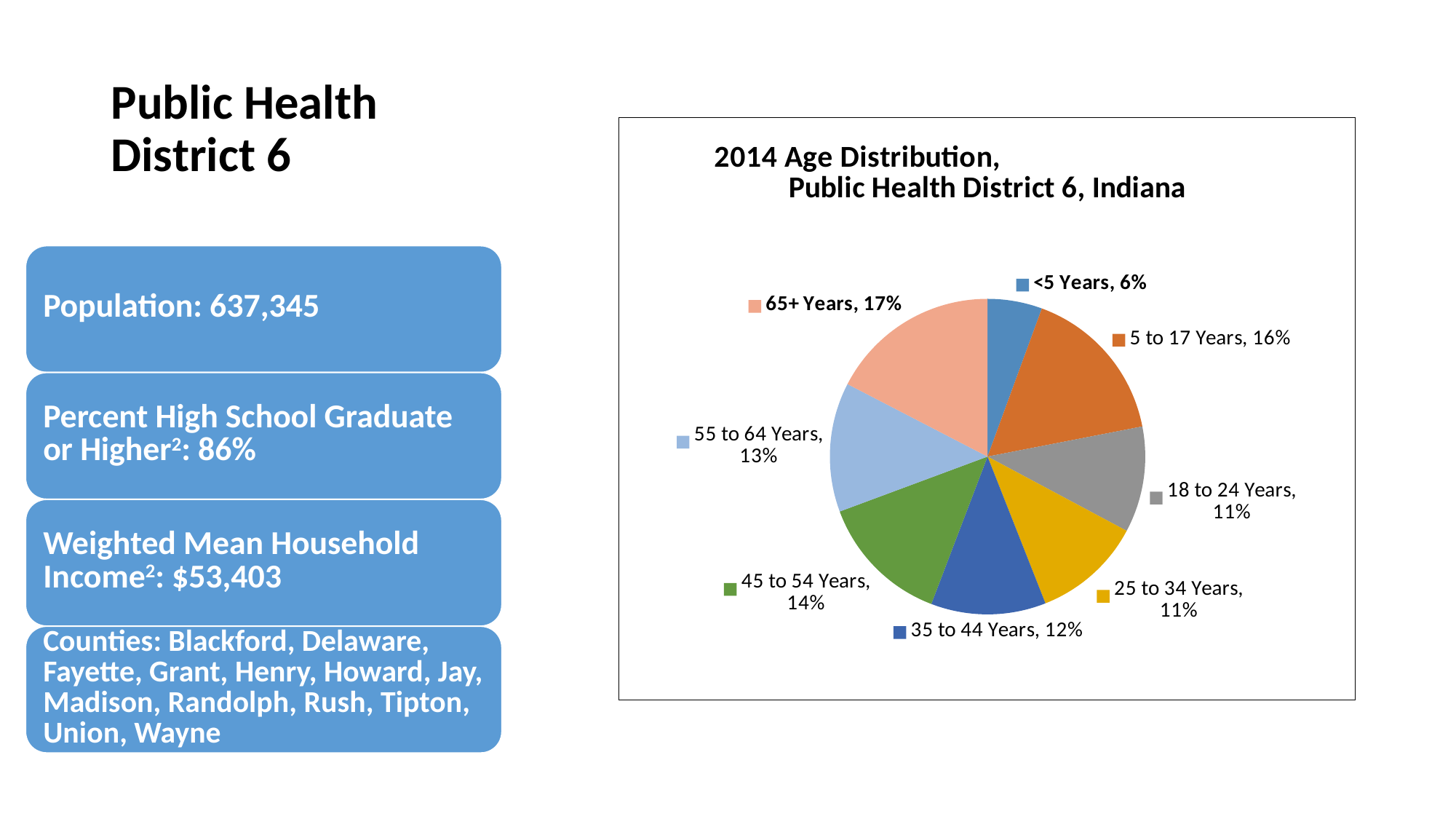
What share of the population is 45 to 54 Years? 14% What is the chart's title? 2014 Age Distribution, Public Health District 6, Indiana Which age group has the smallest share of the pie? <5 Years What share of the population is 5 to 17 Years? 16% What share of the population is 65+ Years? 17% Which age group has the largest share of the pie? 65+ Years What type of chart is shown on the slide? pie chart What is the combined share of the 18 to 24 Years and 25 to 34 Years slices? 22% What share of the population is <5 Years? 6% What is the difference in percentage points between the 65+ Years and <5 Years slices? 11 Which is larger, the share for 55 to 64 Years or the share for 35 to 44 Years? 55 to 64 Years How many age groups are shown in the pie chart? 8